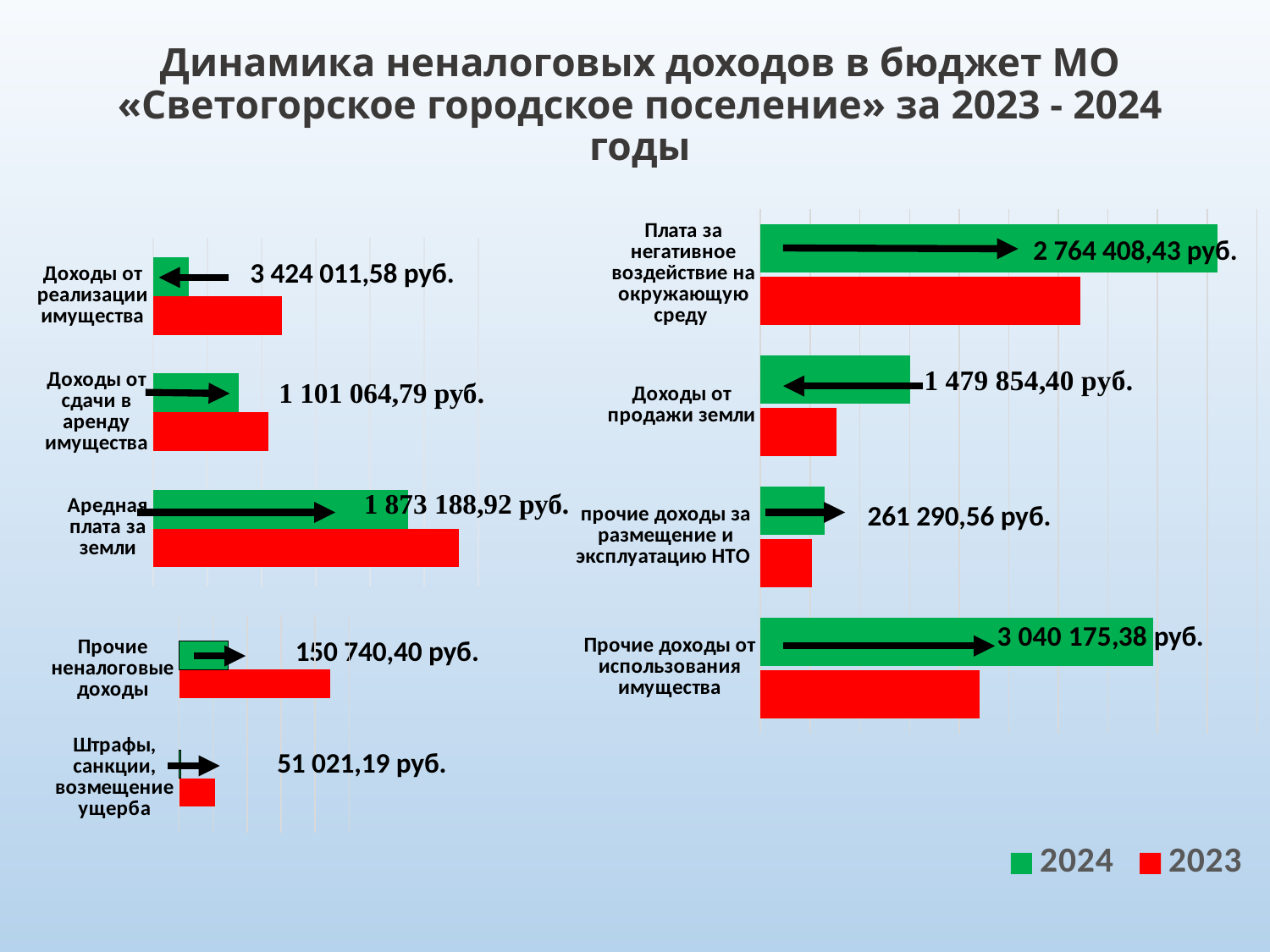
What value is printed on the chart for «Доходы от продажи земли»? 1 479 854,40 руб. What value is printed on the chart for «Штрафы, санкции, возмещение ущерба»? 51 021,19 руб. What value is printed on the chart for «прочие доходы за размещение и эксплуатацию НТО»? 261 290,56 руб. What value is printed on the chart for «Прочие доходы от использования имущества»? 3 040 175,38 руб. In the chart for «Доходы от реализации имущества», which bar is longer, 2024 or 2023? 2023 What value is printed on the chart for «Плата за негативное воздействие на окружающую среду»? 2 764 408,43 руб. How many series does the legend list? 2 What kind of chart is used on the slide? Bar chart In the chart for «Доходы от продажи земли», which bar is longer, 2024 or 2023? 2024 Which colour represents 2023 in the legend? Red What value is printed on the chart for «Доходы от реализации имущества»? 3 424 011,58 руб. In the chart for «Плата за негативное воздействие на окружающую среду», which bar is longer, 2024 or 2023? 2024